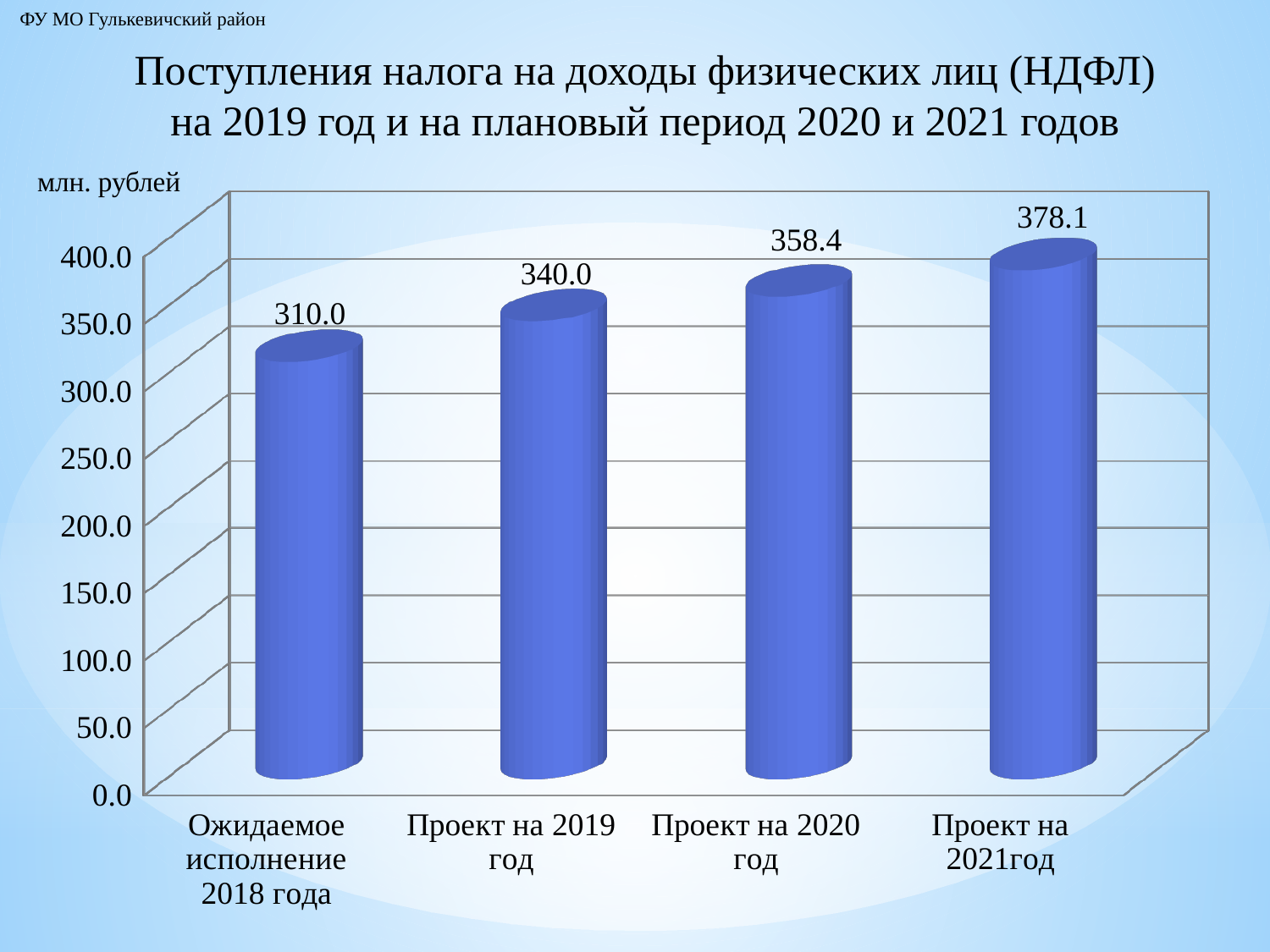
What kind of chart is shown on the slide? bar chart How many categories are shown on the x axis? 4 What is the value for Проект на 2019 год? 340.0 What is the value for Проект на 2021год? 378.1 Which category has the highest value? Проект на 2021год Which is larger, the value for Проект на 2020 год or the value for Ожидаемое исполнение 2018 года? Проект на 2020 год What is the difference between the values for Проект на 2020 год and Проект на 2019 год? 18.4 Do the values rise or fall from left to right along the x axis? rise Which category has the lowest value? Ожидаемое исполнение 2018 года What is the value for Ожидаемое исполнение 2018 года? 310.0 What unit is shown above the vertical axis of the chart? млн. рублей Is the value for Проект на 2021год greater or less than 350.0? greater